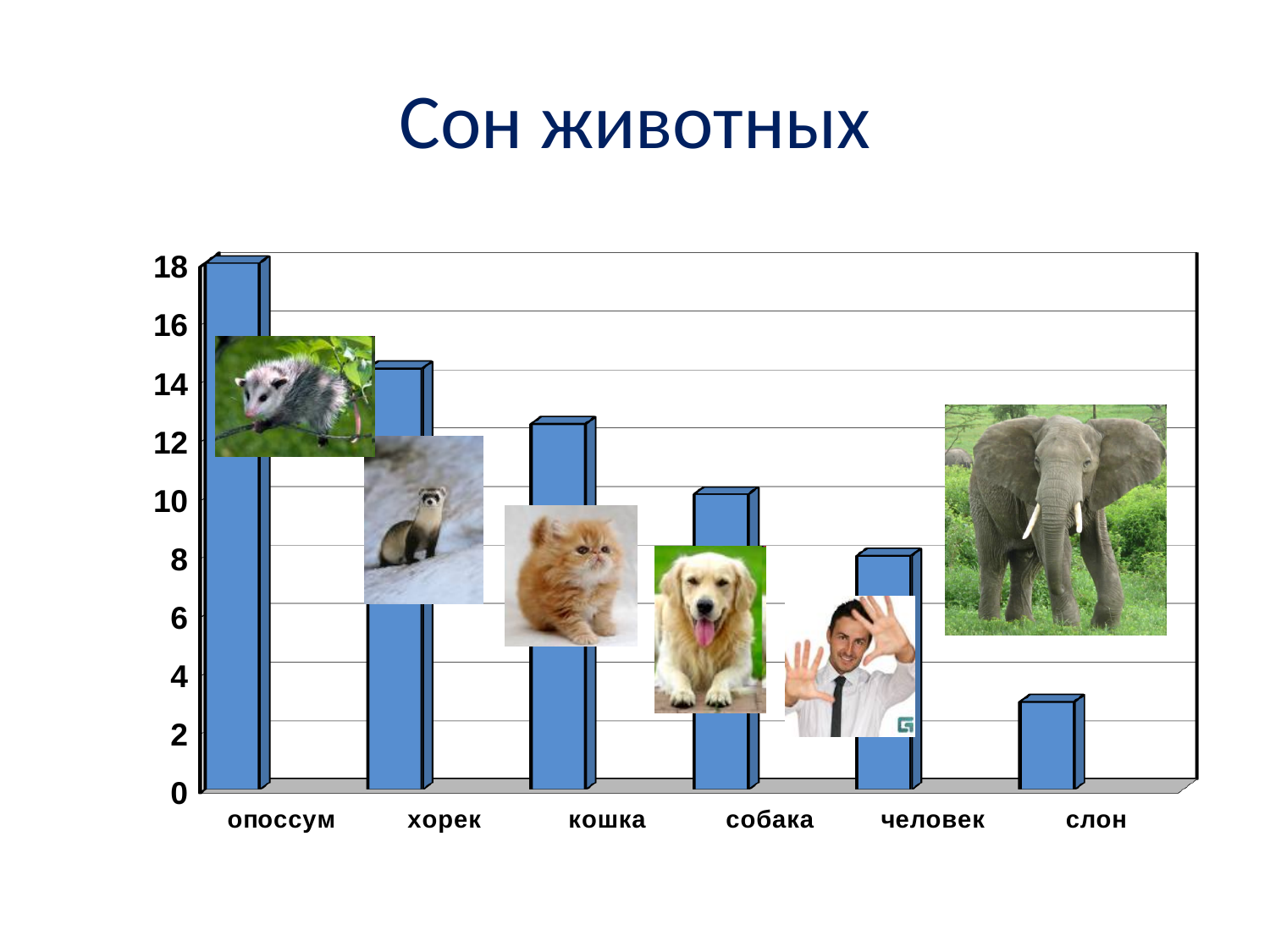
Is the value for кошка greater or less than 14? less Which category has the highest bar? опоссум Which is larger, the value for хорек or the value for кошка? хорек What is the title of the chart? Сон животных What kind of chart is shown on the slide? bar chart Which is larger, the value for собака or the value for слон? собака Is the value for опоссум greater or less than 16? greater Which category has the lowest bar? слон Is the value for слон greater or less than 4? less Do the values rise or fall from left to right along the x axis? fall How many categories are shown on the x axis of the chart? 6